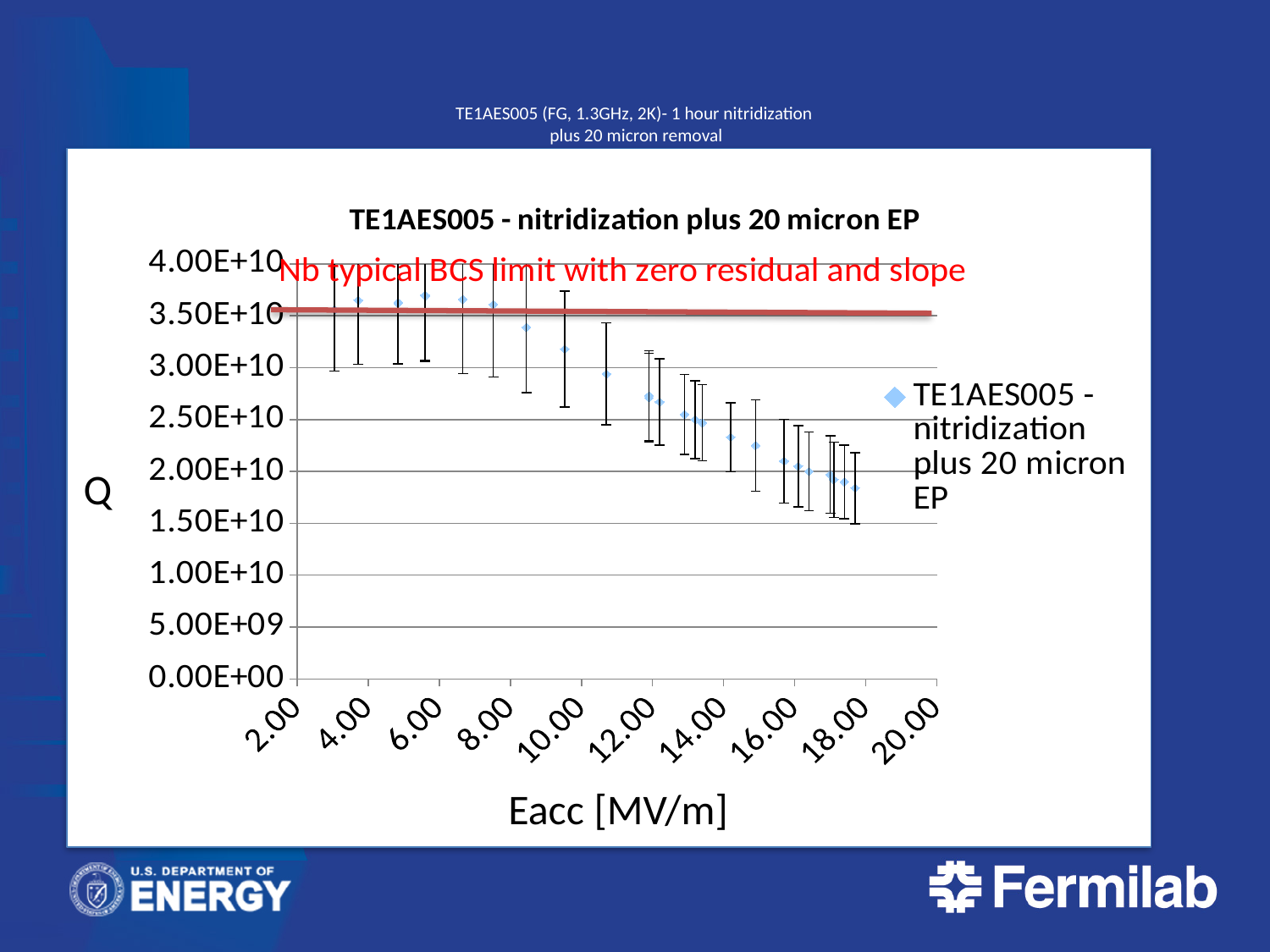
Is the Q value at about 12.00 MV/m greater or less than 2.50E+10? greater Is the Q value at about 4.00 MV/m greater or less than 3.50E+10? greater Is the Q value at about 18.00 MV/m greater or less than 2.50E+10? less Which of the two points has the larger Q value: the one at about 6.00 MV/m or the one at about 16.00 MV/m? The one at about 6.00 MV/m How many series does the chart legend list? 1 What is the highest value shown on the y axis? 4.00E+10 Do the Q values rise or fall as Eacc increases along the x axis? Fall What is the title of the chart? TE1AES005 - nitridization plus 20 micron EP What is the label of the x axis? Eacc [MV/m] What kind of chart is shown on the slide? Scatter chart